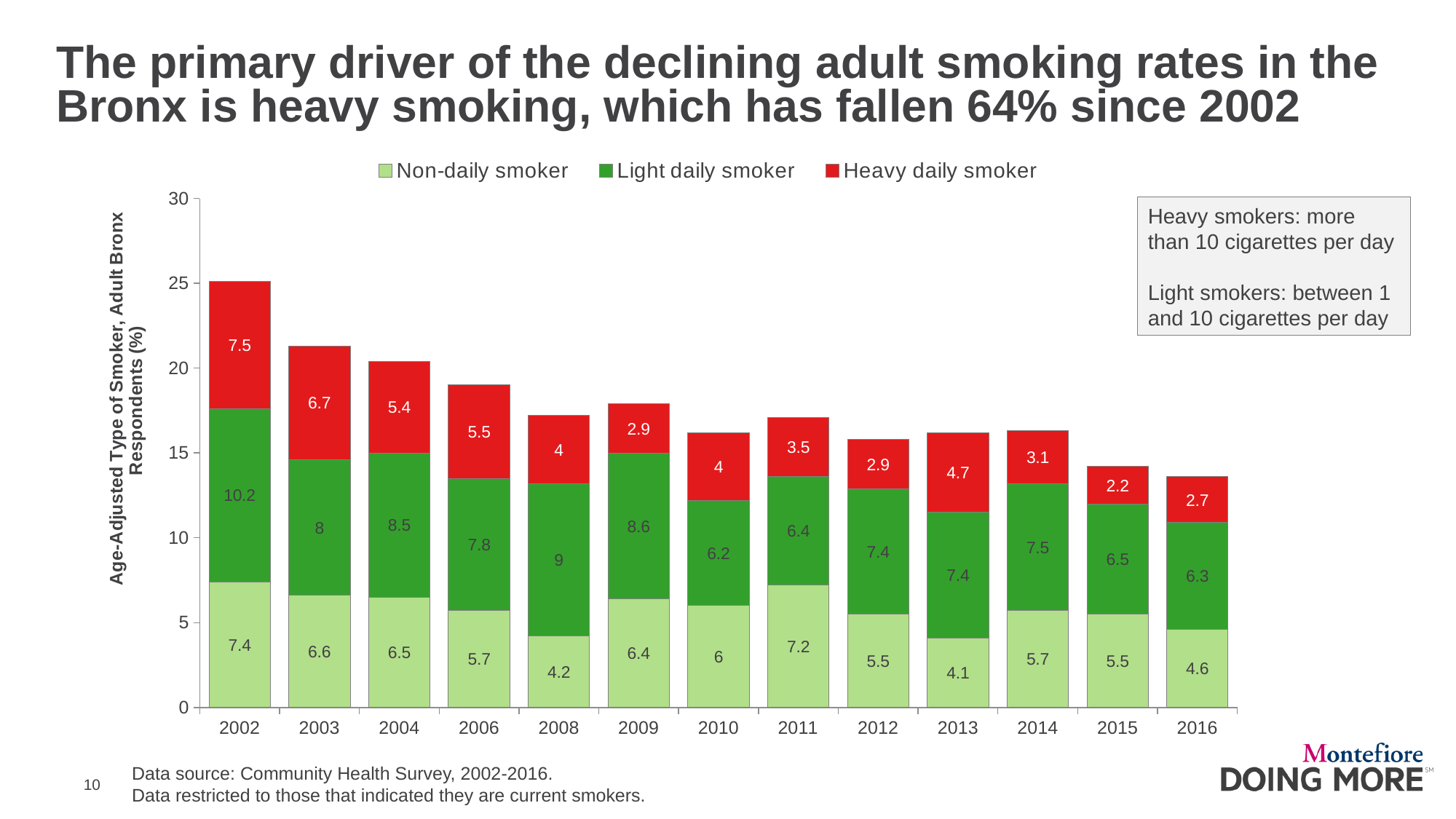
What kind of chart is shown on the slide? Stacked bar chart In which year is the Heavy daily smoker value the highest? 2002 In which year is the Heavy daily smoker value the lowest? 2015 What is the difference between the Heavy daily smoker values in 2002 and 2016? 4.8 What is the value for Non-daily smoker in 2013? 4.1 Is the total height of the stacked bar for 2016 greater or less than 15? less Which is larger, the Non-daily smoker value in 2011 or in 2012? 2011 How many series does the legend list? 3 How many years are shown on the x axis? 13 What is the value for Light daily smoker in 2008? 9 What is the value for Heavy daily smoker in 2002? 7.5 What is the total of the stacked bar for 2002? 25.1